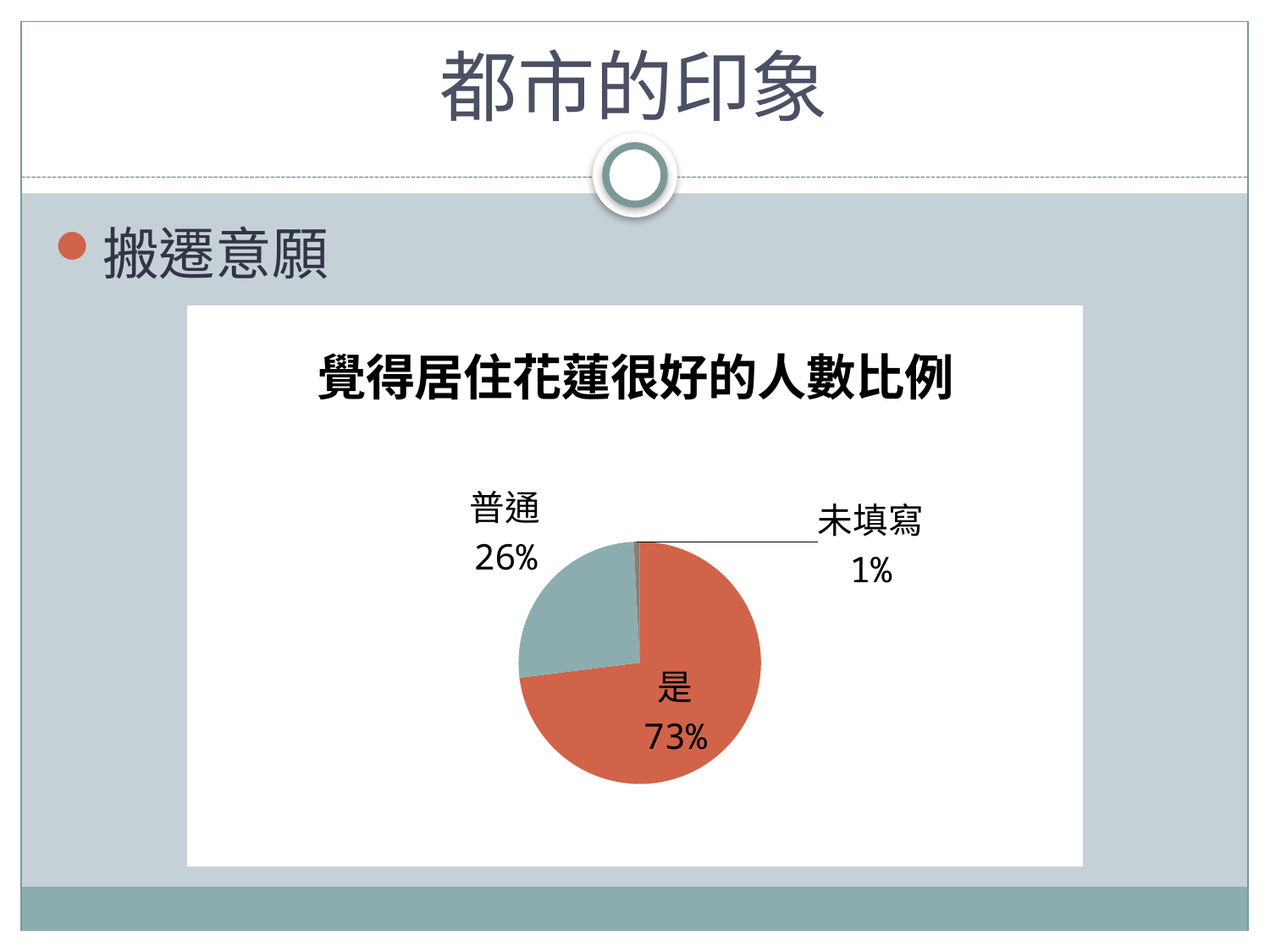
Is the share for 是 greater or less than 50%? greater What type of chart is shown on the slide? pie chart What is the title of the chart? 覺得居住花蓮很好的人數比例 What share of the pie does 未填寫 represent? 1% Which category has the smallest slice of the pie? 未填寫 Which category has the largest slice of the pie? 是 What share of the pie does 普通 represent? 26% How many slices does the pie chart have? 3 What share of the pie does 是 represent? 73% What is the difference in percentage points between 是 and 普通? 47 What colour is the slice for 是? orange-red Which is larger, the share for 普通 or the share for 未填寫? 普通